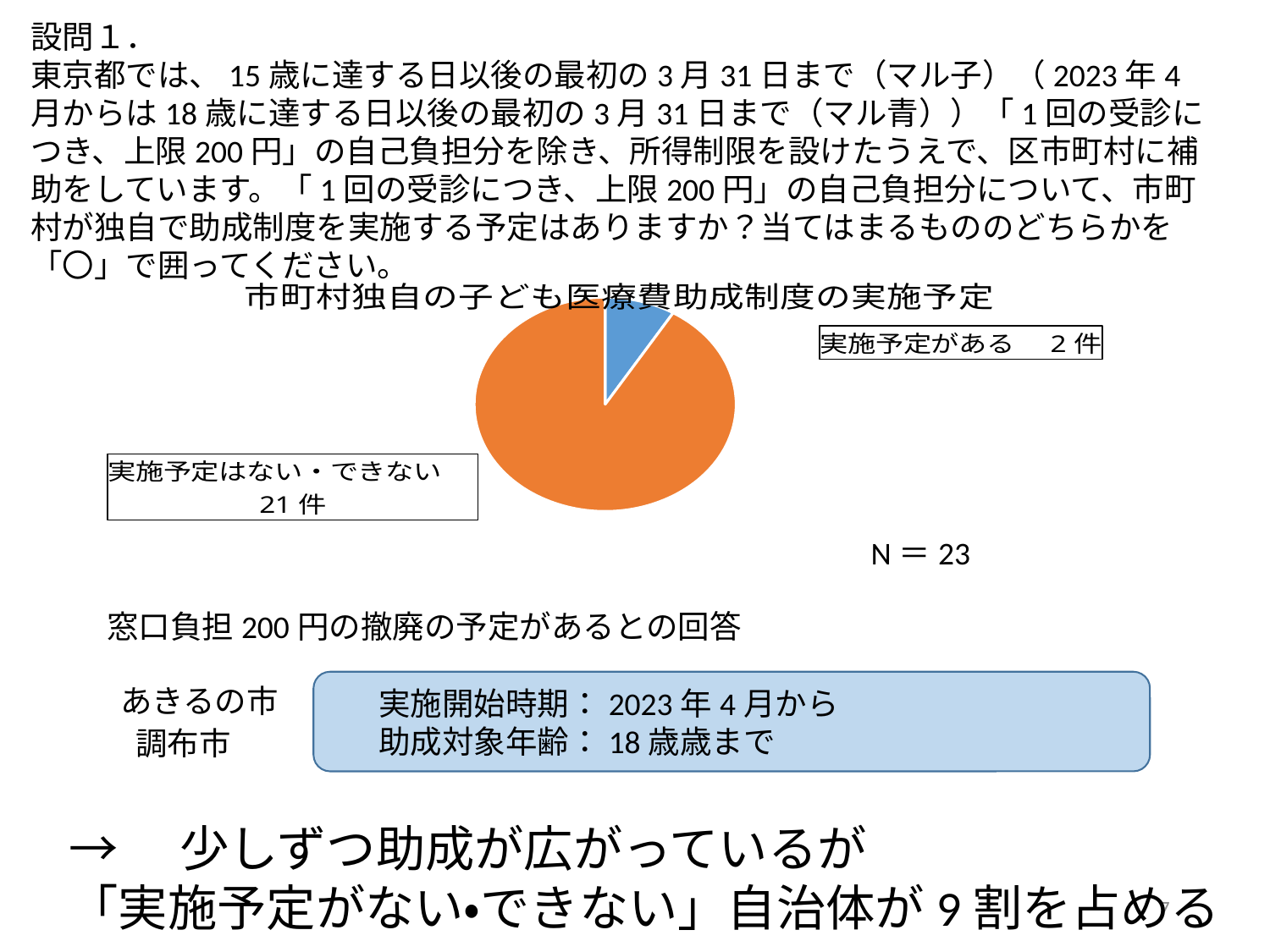
Which category has the largest slice in the pie chart? 実施予定はない・できない What is the title of the pie chart? 市町村独自の子ども医療費助成制度の実施予定 What is the difference between the number of 実施予定はない・できない responses and 実施予定がある responses? 19件 How many responses are labelled 実施予定はない・できない in the pie chart? 21件 How many responses are labelled 実施予定がある in the pie chart? 2件 What colour is the slice for 実施予定はない・できない in the pie chart? orange Which is larger: the number of 実施予定がある responses or the number of 実施予定はない・できない responses? 実施予定はない・できない What is the total number of responses (N) shown for the pie chart? 23 How many slices does the pie chart have? 2 What kind of chart is shown on the slide? pie chart Which category has the smallest slice in the pie chart? 実施予定がある